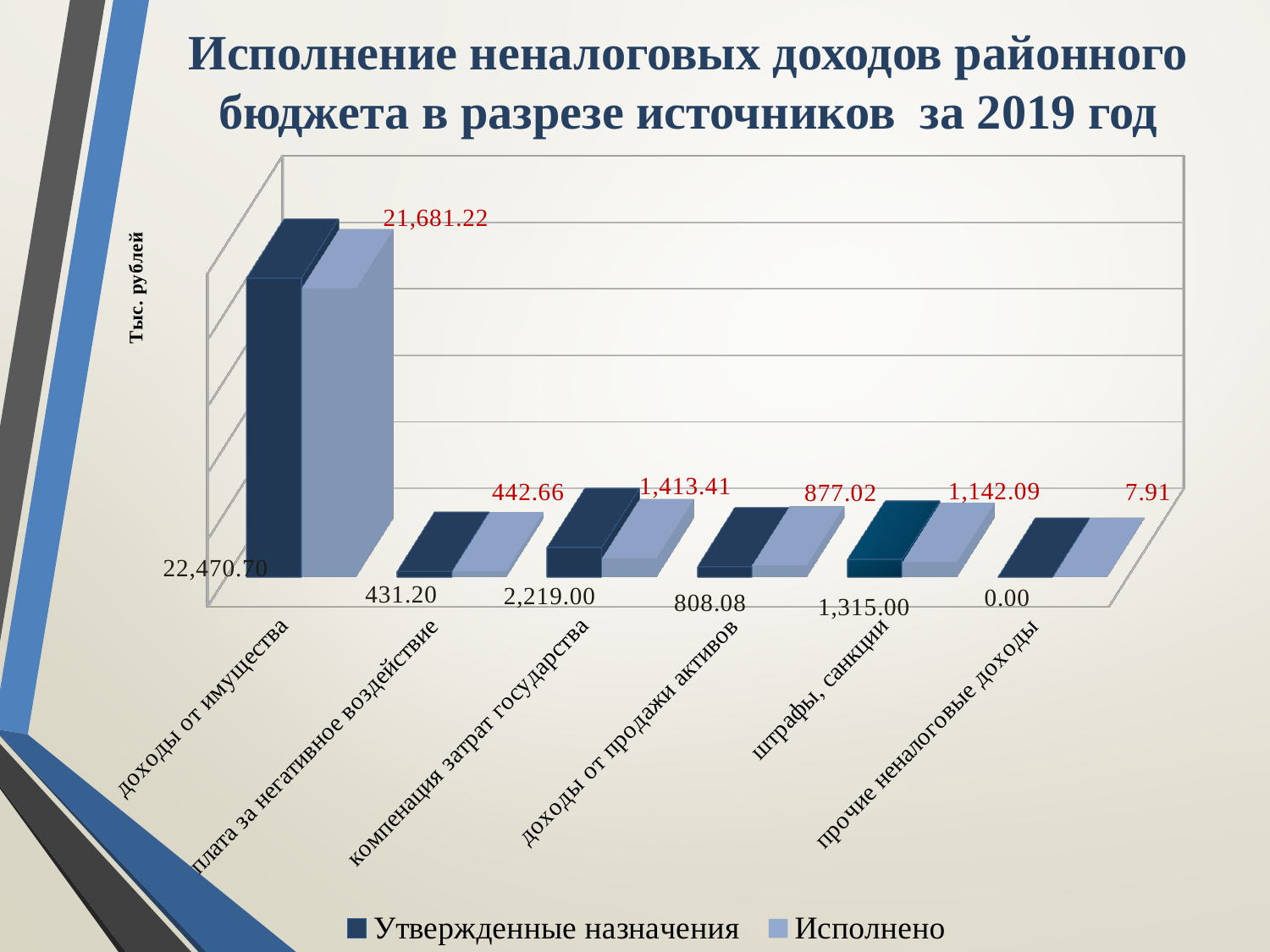
Which category has the highest value for Исполнено? доходы от имущества What is the value of Утвержденные назначения for штрафы, санкции? 1,315.00 What is the value of Исполнено for доходы от имущества? 21,681.22 What is the value of Исполнено for компенсация затрат государства? 1,413.41 How many series does the legend list? 2 What kind of chart is shown on the slide? bar chart What is the value of Утвержденные назначения for доходы от имущества? 22,470.70 Which category has the lowest value for Утвержденные назначения? прочие неналоговые доходы What is the value of Исполнено for прочие неналоговые доходы? 7.91 What is the difference between Утвержденные назначения and Исполнено for компенсация затрат государства? 805.59 How many categories are shown on the x axis? 6 For доходы от продажи активов, which is larger: Утвержденные назначения or Исполнено? Исполнено